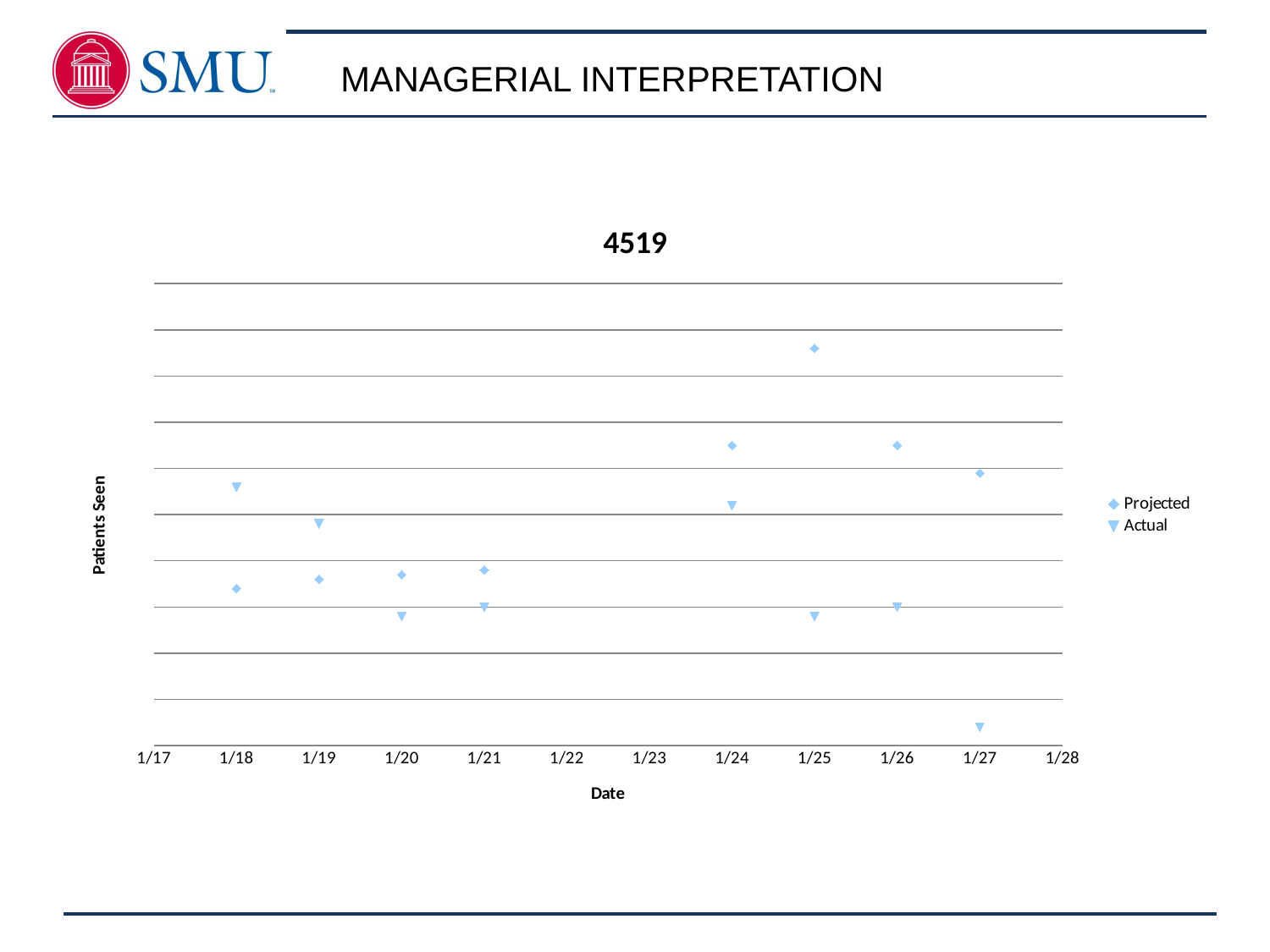
On which date is the Actual value lowest? 1/27 On which date is the Projected value lowest? 1/18 What kind of chart is shown on the slide? scatter chart What is the title of the chart? 4519 How many series does the legend list? 2 On which date is the Projected value highest? 1/25 On which date is the Actual value highest? 1/18 How many Actual data points are plotted on the chart? 8 On 1/18, which is larger, the Projected value or the Actual value? Actual On 1/25, which is larger, the Projected value or the Actual value? Projected What are the two series named in the legend? Projected and Actual How many Projected data points are plotted on the chart? 8